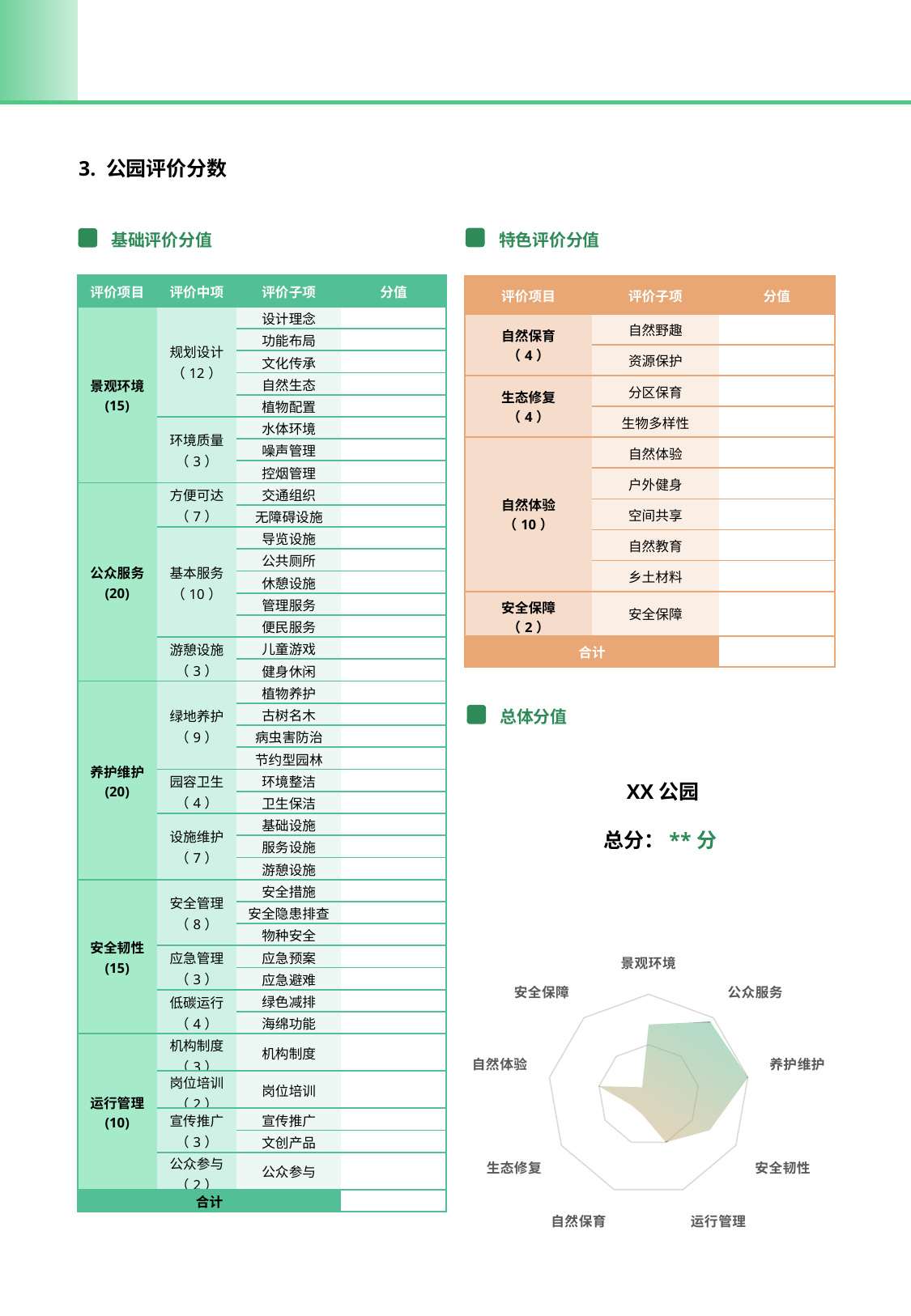
On the radar chart, which is larger: 养护维护 or 生态修复? 养护维护 What park name is shown above the radar chart in the 总体分值 section? XX 公园 Which category label appears at the top of the radar chart? 景观环境 On the radar chart, which is larger: 公众服务 or 自然体验? 公众服务 How many categories (axes) does the radar chart have? 9 Which category on the radar chart has the highest value? 养护维护 What kind of chart is shown under 总体分值? radar chart